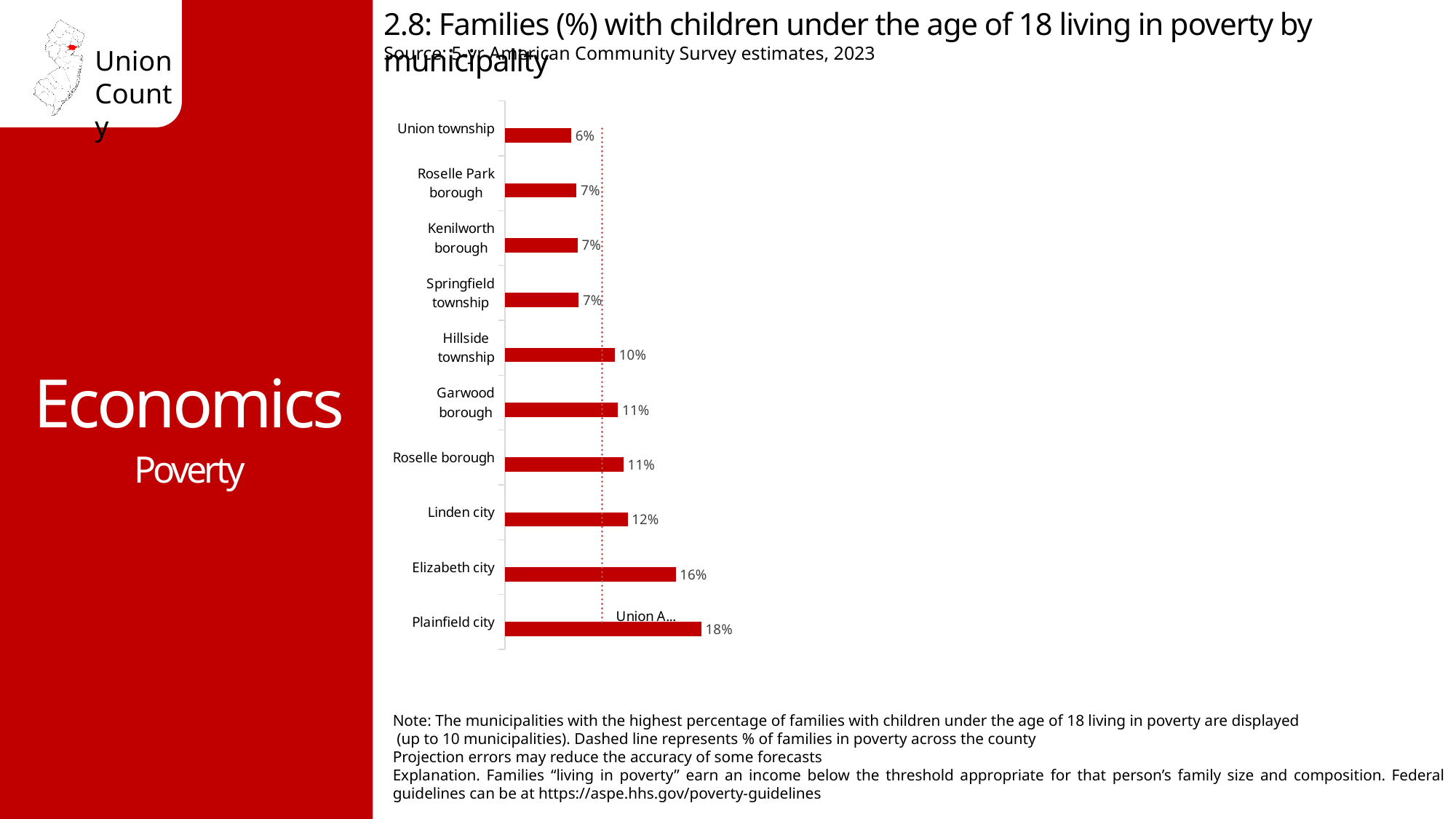
What is the difference in percentage points between Plainfield city and Elizabeth city? 2% According to the note, what does the dashed line on the chart represent? % of families in poverty across the county What is the value shown for Elizabeth city? 16% What is the value shown for Hillside township? 10% How many municipalities are shown on the chart? 10 What is the value shown for Union township? 6% Which municipality has the highest percentage of families with children under 18 living in poverty? Plainfield city What type of chart is used on this slide? Bar chart Which municipality has the lowest percentage shown on the chart? Union township What percentage of families with children under 18 are living in poverty in Plainfield city? 18% Which has a higher value, Linden city or Garwood borough? Linden city What is the difference between Linden city and Union township? 6%